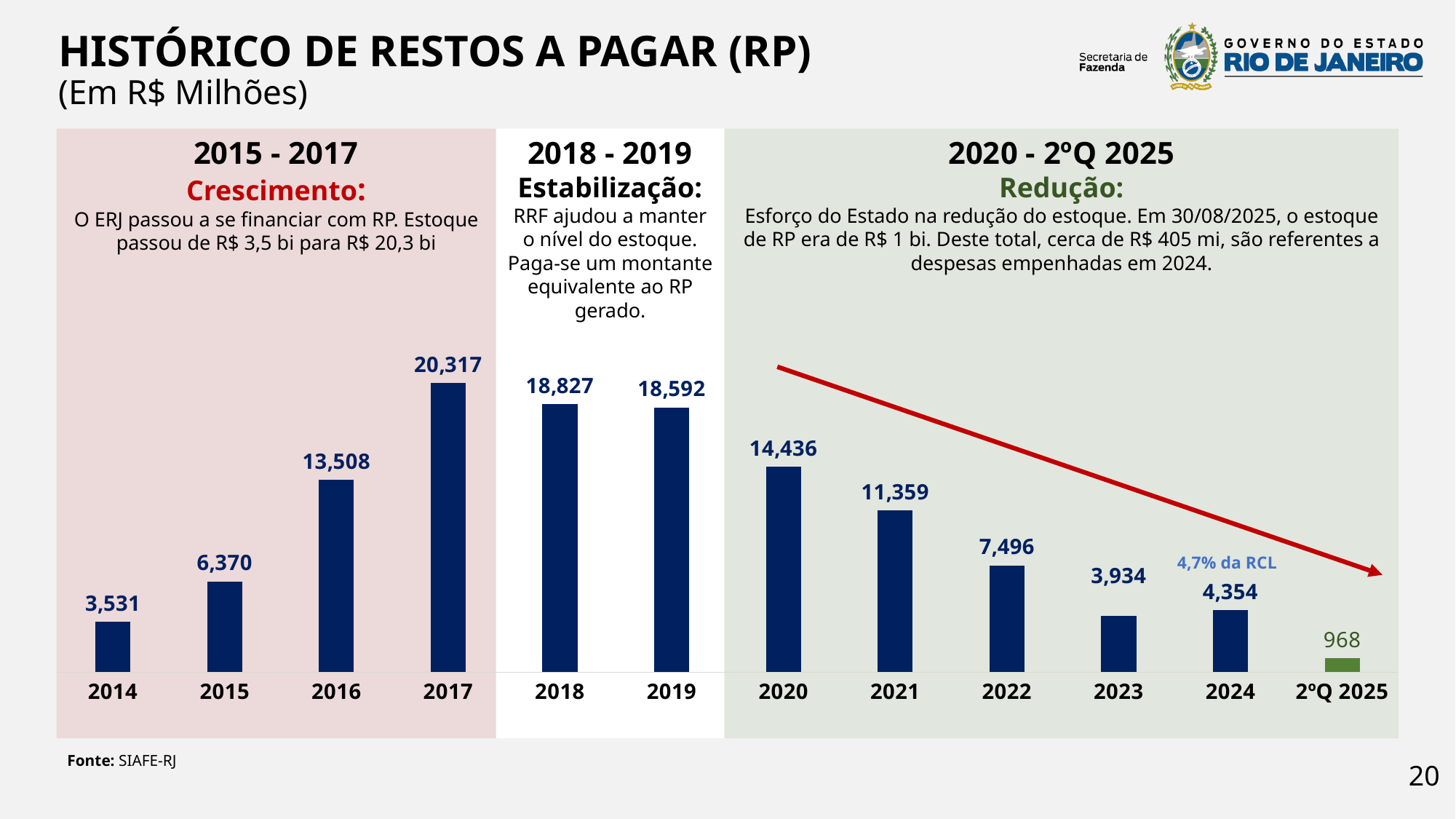
What is the difference between the values for 2018 and 2019? 235 Which category has the lowest value? 2ºQ 2025 What is the value for 2017? 20,317 What is the source cited below the chart? SIAFE-RJ What is the value for 2ºQ 2025? 968 Which is larger, the value for 2016 or the value for 2020? 2020 What kind of chart is shown on the slide? Bar chart What is the value for 2021? 11,359 Which year has the highest value? 2017 How many categories are shown on the x axis? 12 Do the values rise or fall from 2020 to 2023? Fall What is the difference between the values for 2024 and 2023? 420